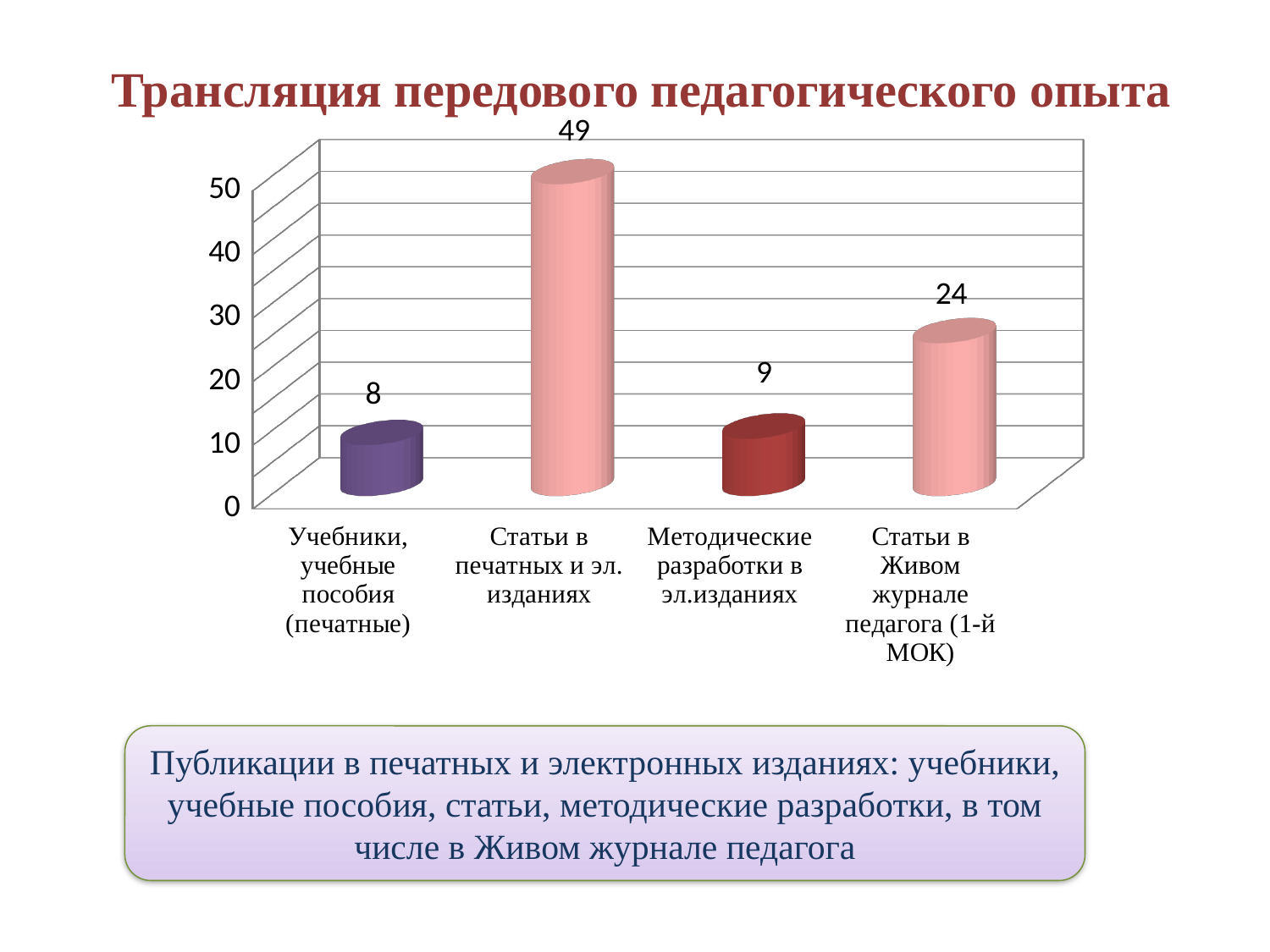
Which category has the highest value? Статьи в печатных и эл. изданиях What kind of chart is shown on the slide? bar chart What is the value for "Учебники, учебные пособия (печатные)"? 8 What is the value for "Статьи в печатных и эл. изданиях"? 49 What is the title of the slide above the chart? Трансляция передового педагогического опыта Is the value for "Статьи в Живом журнале педагога (1-й МОК)" greater or less than 20? greater How many categories are shown in the chart? 4 What is the value for "Статьи в Живом журнале педагога (1-й МОК)"? 24 What is the value for "Методические разработки в эл.изданиях"? 9 Which category has the lowest value? Учебники, учебные пособия (печатные) What is the difference between the values for "Статьи в печатных и эл. изданиях" and "Статьи в Живом журнале педагога (1-й МОК)"? 25 Which is larger: the value for "Методические разработки в эл.изданиях" or for "Учебники, учебные пособия (печатные)"? Методические разработки в эл.изданиях